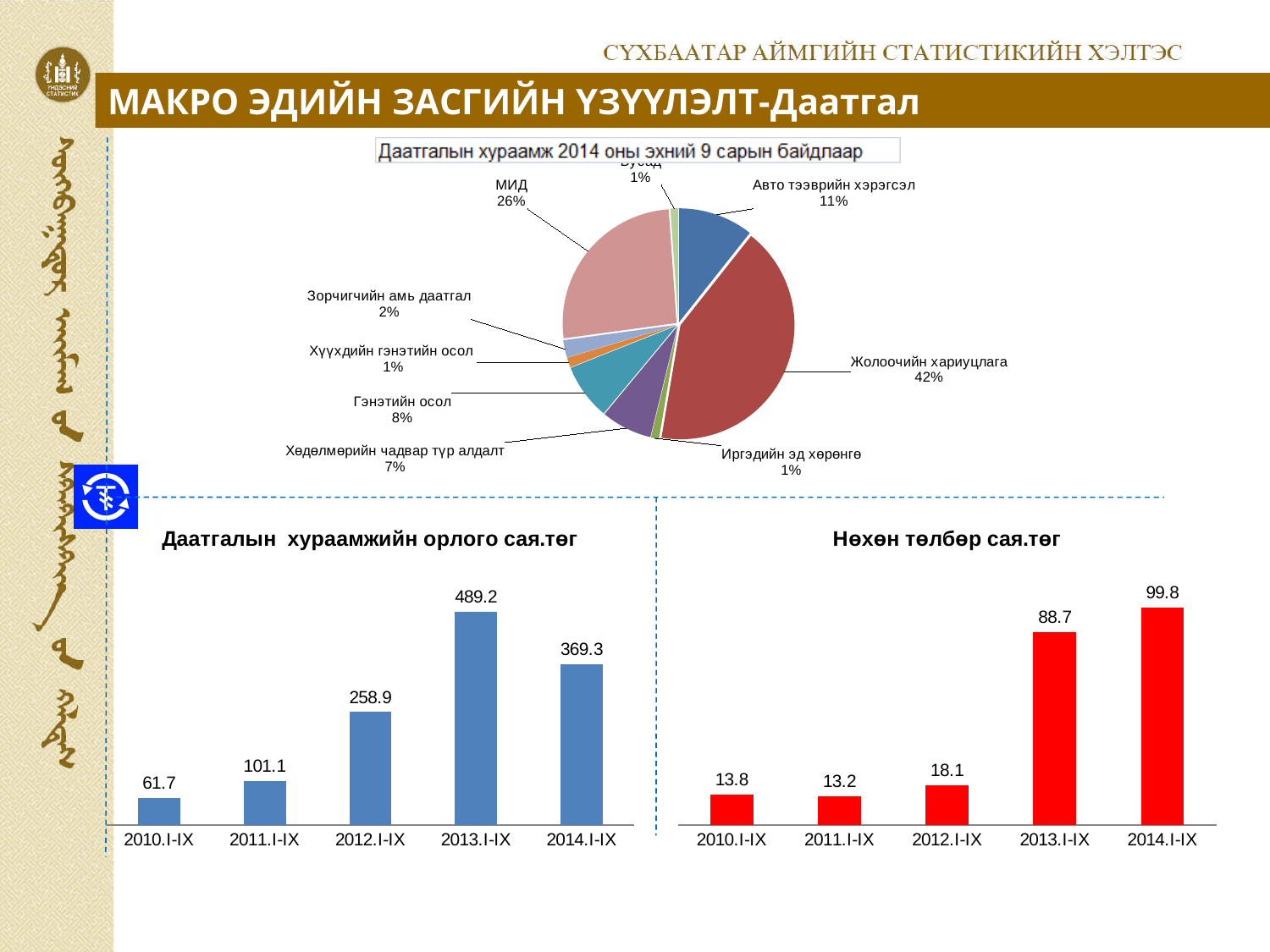
In the chart 'Нөхөн төлбөр сая.төг', how many periods are shown on the x axis? 5 In the pie chart 'Даатгалын хураамж 2014 оны эхний 9 сарын байдлаар', what share does 'Жолоочийн хариуцлага' have? 42% In the chart 'Даатгалын хураамжийн орлого сая.төг', what is the value for 2013.I-IX? 489.2 In the pie chart 'Даатгалын хураамж 2014 оны эхний 9 сарын байдлаар', what share does 'МИД' have? 26% In the chart 'Нөхөн төлбөр сая.төг', what is the value for 2014.I-IX? 99.8 In the chart 'Даатгалын хураамжийн орлого сая.төг', what is the value for 2010.I-IX? 61.7 In the pie chart 'Даатгалын хураамж 2014 оны эхний 9 сарын байдлаар', which is larger: 'Гэнэтийн осол' or 'Хөдөлмөрийн чадвар түр алдалт'? Гэнэтийн осол What type of chart is 'Нөхөн төлбөр сая.төг'? Bar chart In the pie chart 'Даатгалын хураамж 2014 оны эхний 9 сарын байдлаар', which category has the largest share? Жолоочийн хариуцлага In the chart 'Даатгалын хураамжийн орлого сая.төг', what is the difference between 2013.I-IX and 2014.I-IX? 119.9 In the chart 'Нөхөн төлбөр сая.төг', which period has the lowest value? 2011.I-IX In the chart 'Даатгалын хураамжийн орлого сая.төг', which period has the highest value? 2013.I-IX